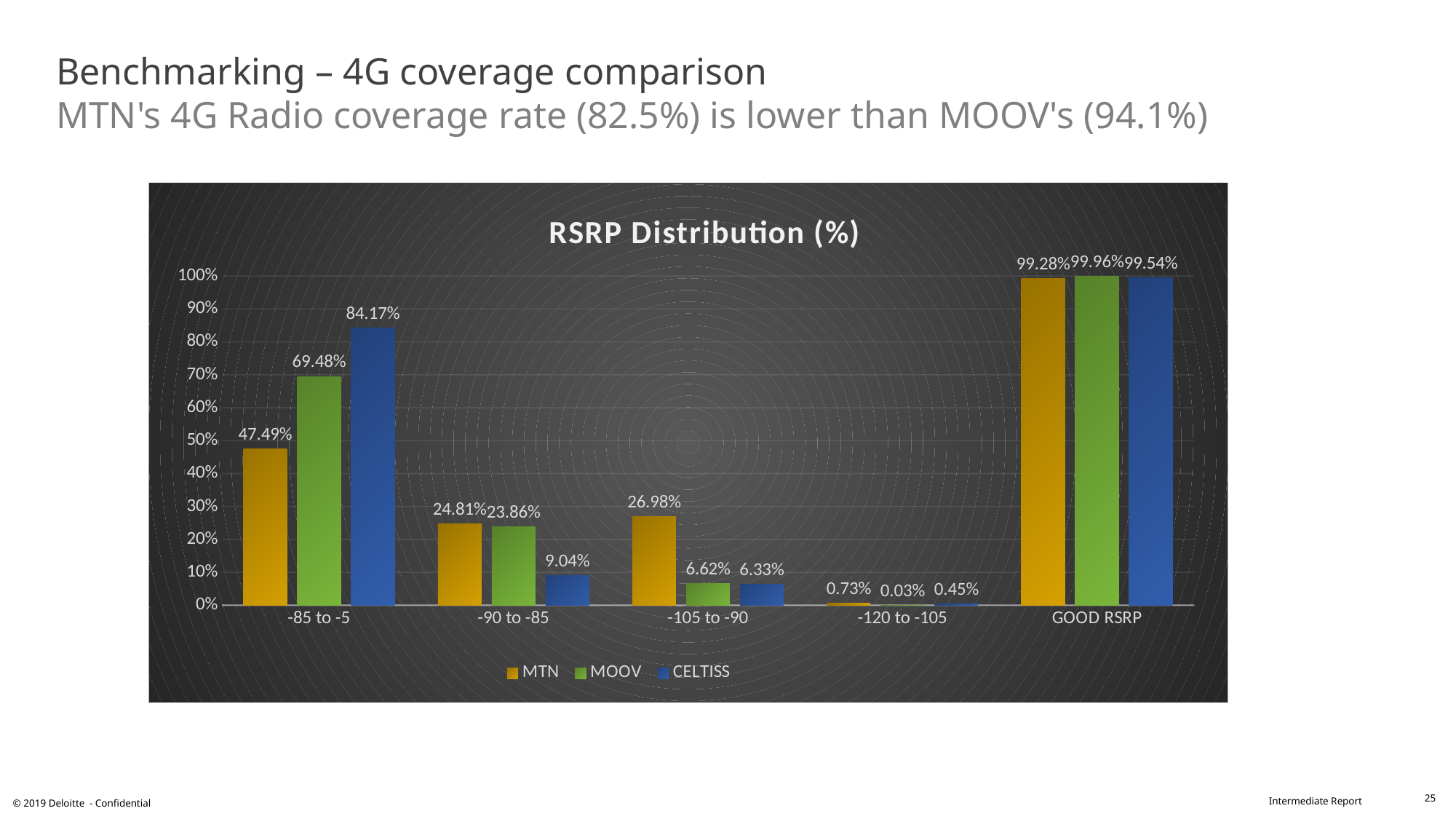
Which series has the lowest value in the -120 to -105 category? MOOV What is the CELTISS value for the -90 to -85 category? 9.04% Which series has the highest value in the -85 to -5 category? CELTISS What is the title of the chart? RSRP Distribution (%) What kind of chart is shown on the slide? Bar chart Which is larger in the -90 to -85 category, the MTN value or the MOOV value? MTN What is the MTN value for the -85 to -5 category? 47.49% What is the difference between the CELTISS and MOOV values in the -85 to -5 category? 14.69% What is the MOOV value for the -105 to -90 category? 6.62% What is the MOOV value for the -120 to -105 category? 0.03% How many series does the legend list? 3 How many categories are shown on the x axis? 5